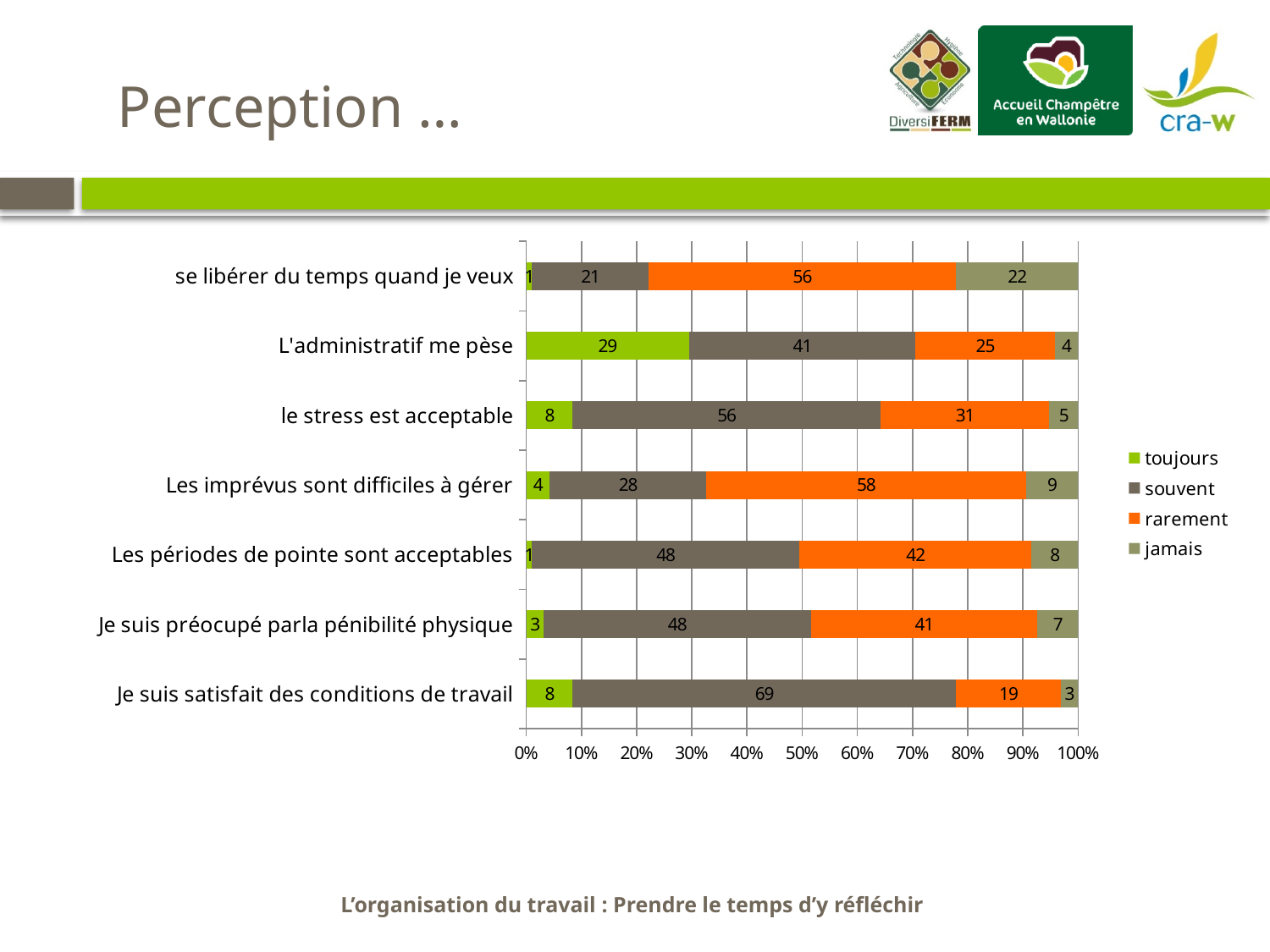
What is the difference between the 'souvent' values for 'le stress est acceptable' and 'Les imprévus sont difficiles à gérer'? 28 How many series does the legend list? 4 What kind of chart is shown on the slide? Stacked bar chart Which is larger: the 'rarement' value for 'L'administratif me pèse' or for 'le stress est acceptable'? le stress est acceptable What is the 'toujours' value for 'L'administratif me pèse'? 29 Which category has the lowest 'souvent' value? se libérer du temps quand je veux What is the 'jamais' value for 'se libérer du temps quand je veux'? 22 Which colour represents the 'rarement' series in the legend? Orange How many categories are shown on the chart? 7 Which category has the highest 'toujours' value? L'administratif me pèse What is the 'souvent' value for 'Je suis satisfait des conditions de travail'? 69 What is the 'rarement' value for 'Les imprévus sont difficiles à gérer'? 58